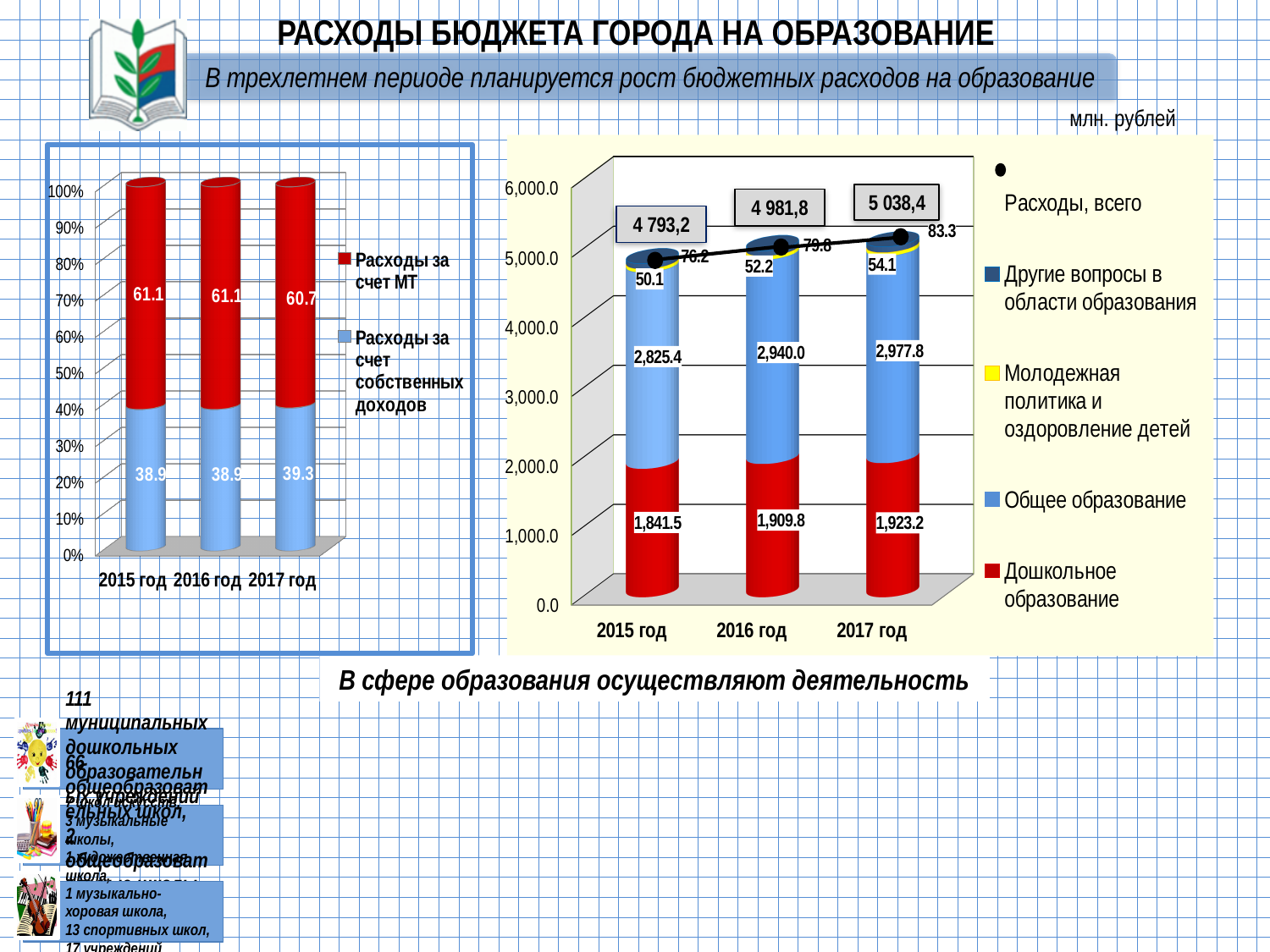
In the right chart, what is the total 'Расходы, всего' for 2015 год? 4 793,2 In the right chart, what is the value of 'Дошкольное образование' for 2016 год? 1,909.8 In the right chart, how many entries does the legend list? 5 In the right chart, how many categories are shown on the x axis? 3 In the left chart, what is the value of 'Расходы за счет собственных доходов' for 2015 год? 38.9 In the right chart, which year has the highest 'Расходы, всего'? 2017 год In the left chart, how many series does the legend list? 2 In the right chart, what is the value of 'Общее образование' for 2017 год? 2,977.8 In the right chart, what is the difference between 'Общее образование' in 2016 год and 2015 год? 114.6 In the left chart, what kind of chart is shown? Stacked bar chart In the left chart, what is the value of 'Расходы за счет МТ' for 2017 год? 60.7 In the right chart, does 'Расходы, всего' rise or fall from 2015 год to 2017 год? Rise